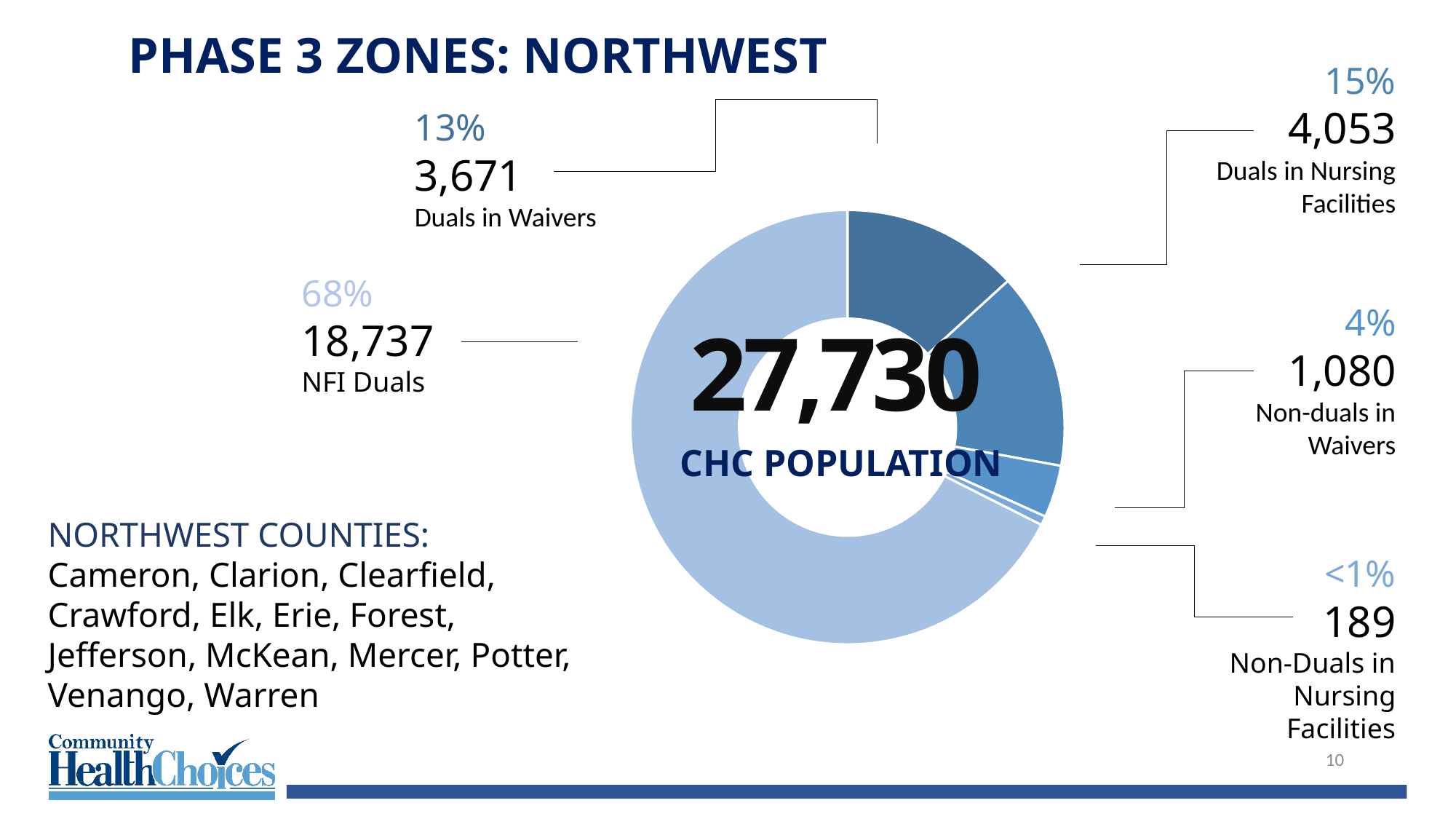
How many categories are shown in the donut chart? 5 Which category has the smallest share of the CHC population? Non-Duals in Nursing Facilities What percentage is shown for Non-Duals in Nursing Facilities? <1% How many Non-duals in Waivers are shown? 1,080 Which is larger: Duals in Waivers or Non-duals in Waivers? Duals in Waivers What share of the CHC population are NFI Duals? 68% Which category has the largest share of the CHC population? NFI Duals What is the total CHC population shown in the center of the donut chart? 27,730 What type of chart is used to show the CHC population? Donut (pie) chart How many NFI Duals are shown on the chart? 18,737 What percentage of the CHC population are Duals in Nursing Facilities? 15% What is the difference between the number of Duals in Nursing Facilities and Duals in Waivers? 382